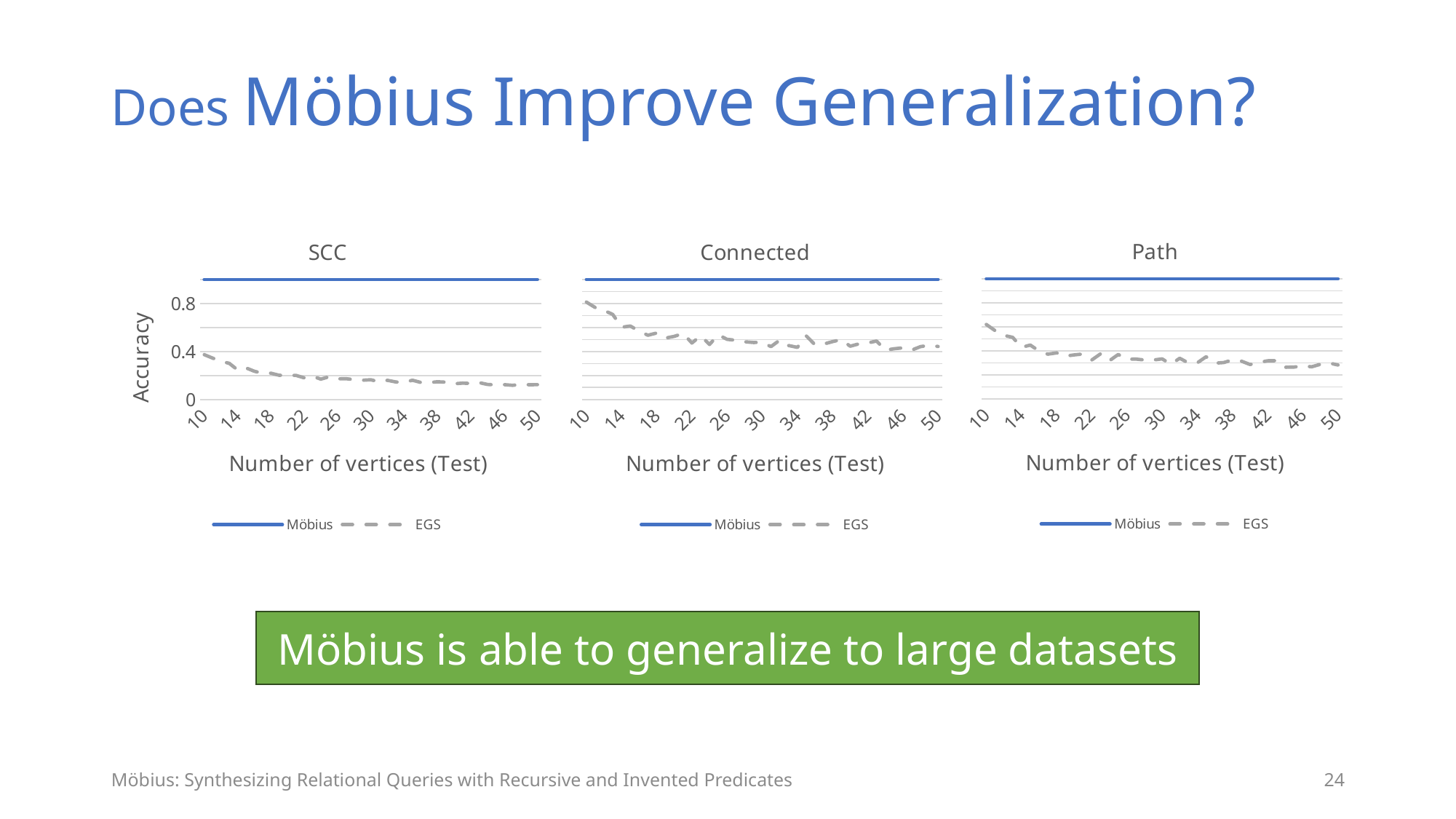
In the SCC chart, does the EGS line rise or fall as the number of vertices increases? fall How many series does the legend of the Connected chart list? 2 How many x-axis tick labels (numbers of vertices) are shown on the Path chart? 11 Which series is drawn with a dashed gray line in the SCC chart? EGS What kind of chart is the SCC chart? line chart What is the x-axis label of the Connected chart? Number of vertices (Test) In the Connected chart, is the accuracy of EGS at 50 vertices greater or less than 0.8? less In the Connected chart, does the EGS line rise or fall as the number of vertices increases? fall In the SCC chart, is the accuracy of EGS at 50 vertices greater or less than 0.4? less In the Path chart, which series has the higher accuracy at 50 vertices, Möbius or EGS? Möbius In the Path chart, is the accuracy of EGS at 10 vertices greater or less than 0.4? greater